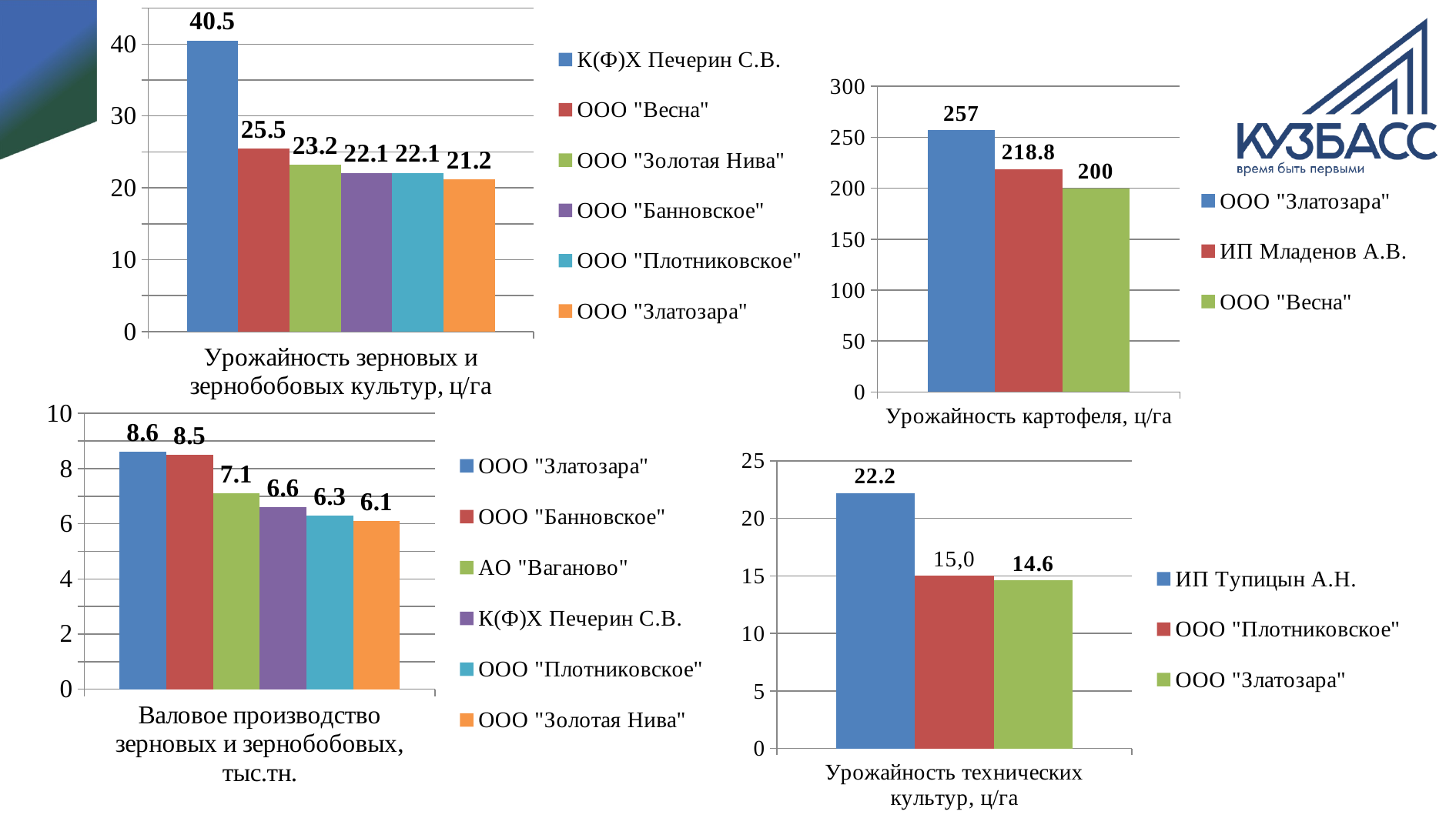
In the chart 'Валовое производство зерновых и зернобобовых, тыс.тн.', which is larger: ООО "Плотниковское" or ООО "Золотая Нива"? ООО "Плотниковское" In the chart 'Урожайность зерновых и зернобобовых культур, ц/га', what is the value for К(Ф)Х Печерин С.В.? 40.5 In the chart 'Урожайность зерновых и зернобобовых культур, ц/га', which series has the lowest value? ООО "Златозара" What kind of chart is 'Валовое производство зерновых и зернобобовых, тыс.тн.'? Bar chart In the chart 'Валовое производство зерновых и зернобобовых, тыс.тн.', what is the value for АО "Ваганово"? 7.1 In the chart 'Урожайность картофеля, ц/га', which series has the highest value? ООО "Златозара" How many series does the legend of the chart 'Урожайность зерновых и зернобобовых культур, ц/га' list? 6 How many bars are plotted in the chart 'Урожайность технических культур, ц/га'? 3 In the chart 'Урожайность картофеля, ц/га', what is the difference between ООО "Златозара" and ООО "Весна"? 57 In the chart 'Урожайность зерновых и зернобобовых культур, ц/га', what is the difference between К(Ф)Х Печерин С.В. and ООО "Весна"? 15 In the chart 'Урожайность картофеля, ц/га', what is the value for ИП Младенов А.В.? 218.8 In the chart 'Урожайность технических культур, ц/га', what is the value for ИП Тупицын А.Н.? 22.2